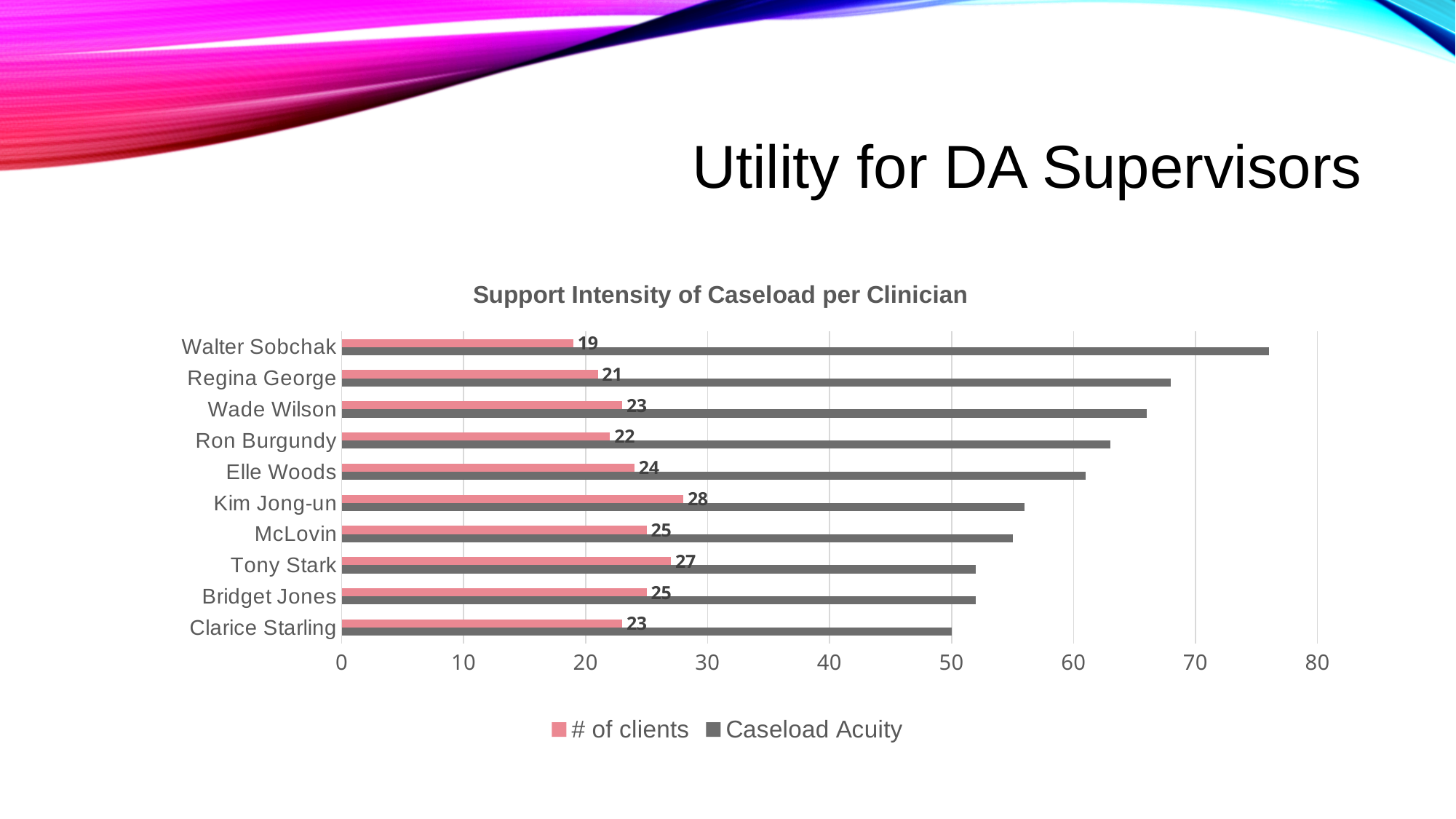
What kind of chart is shown on the slide? Bar chart Which clinician has the lowest # of clients? Walter Sobchak Is the Caseload Acuity value for Walter Sobchak greater or less than 70? greater Is the Caseload Acuity value for Clarice Starling greater or less than 60? less Which clinician has the highest # of clients? Kim Jong-un Which clinician has the highest Caseload Acuity? Walter Sobchak Who has more clients, Tony Stark or McLovin? Tony Stark How many clinicians are shown in the chart? 10 What is the # of clients for Walter Sobchak? 19 What is the difference in # of clients between Kim Jong-un and Walter Sobchak? 9 What is the # of clients for Kim Jong-un? 28 How many series does the legend list? 2